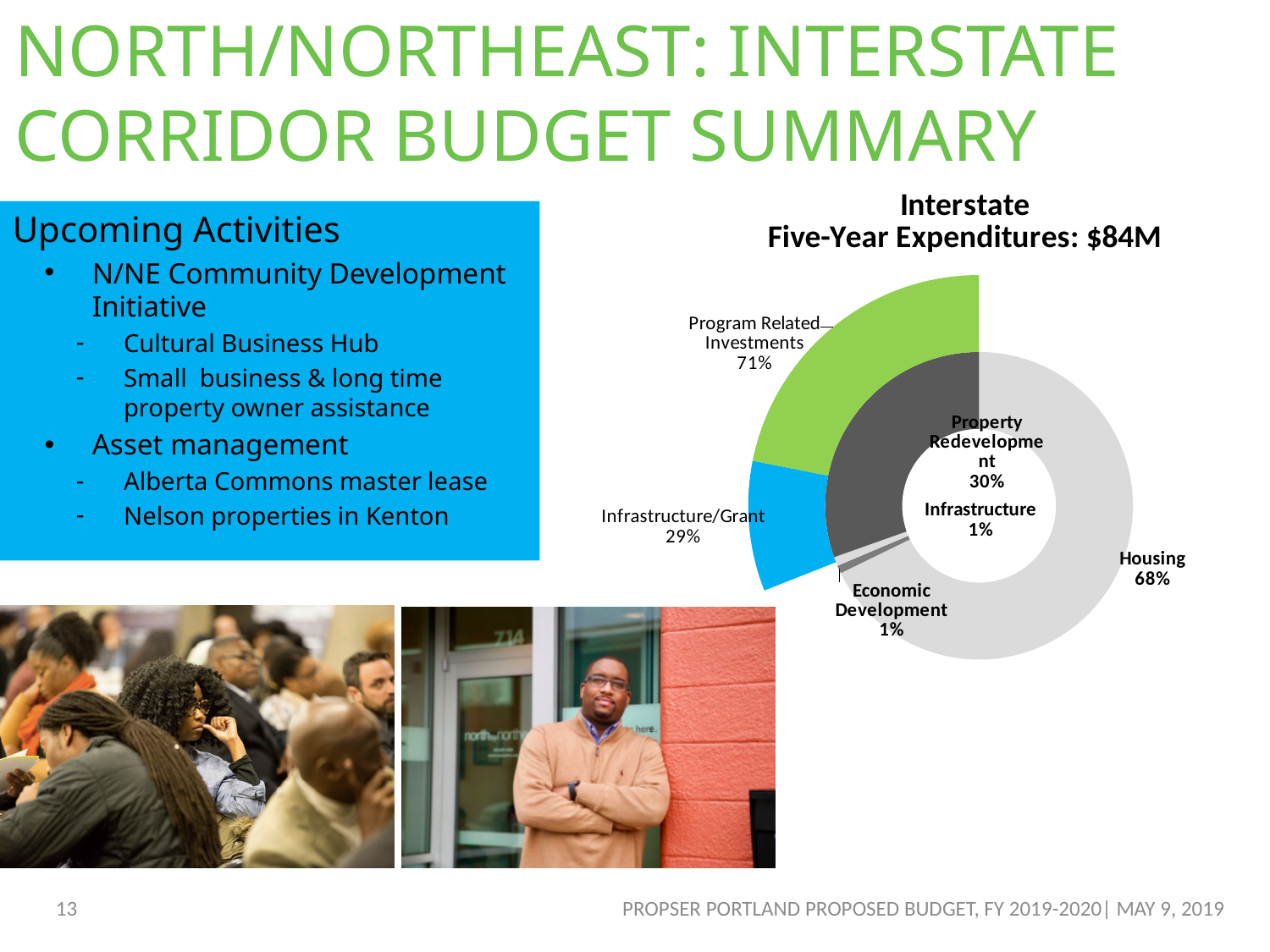
What percentage is shown for Economic Development in the chart? 1% What percentage is shown for Infrastructure/Grant in the outer ring of the chart? 29% How many categories are labeled in the inner ring of the Interstate Five-Year Expenditures chart? 4 What is the difference in percentage points between Housing and Property Redevelopment in the chart? 38 What share of the inner ring does Housing represent in the Interstate Five-Year Expenditures chart? 68% What percentage is shown for Program Related Investments in the outer ring of the chart? 71% Which category has the largest share in the inner ring of the Interstate Five-Year Expenditures chart? Housing What is the difference in percentage points between Program Related Investments and Infrastructure/Grant? 42 What percentage is shown for Property Redevelopment in the Interstate Five-Year Expenditures chart? 30% Which is larger in the chart, Property Redevelopment or Infrastructure? Property Redevelopment What total five-year expenditure amount is stated in the chart title? $84M